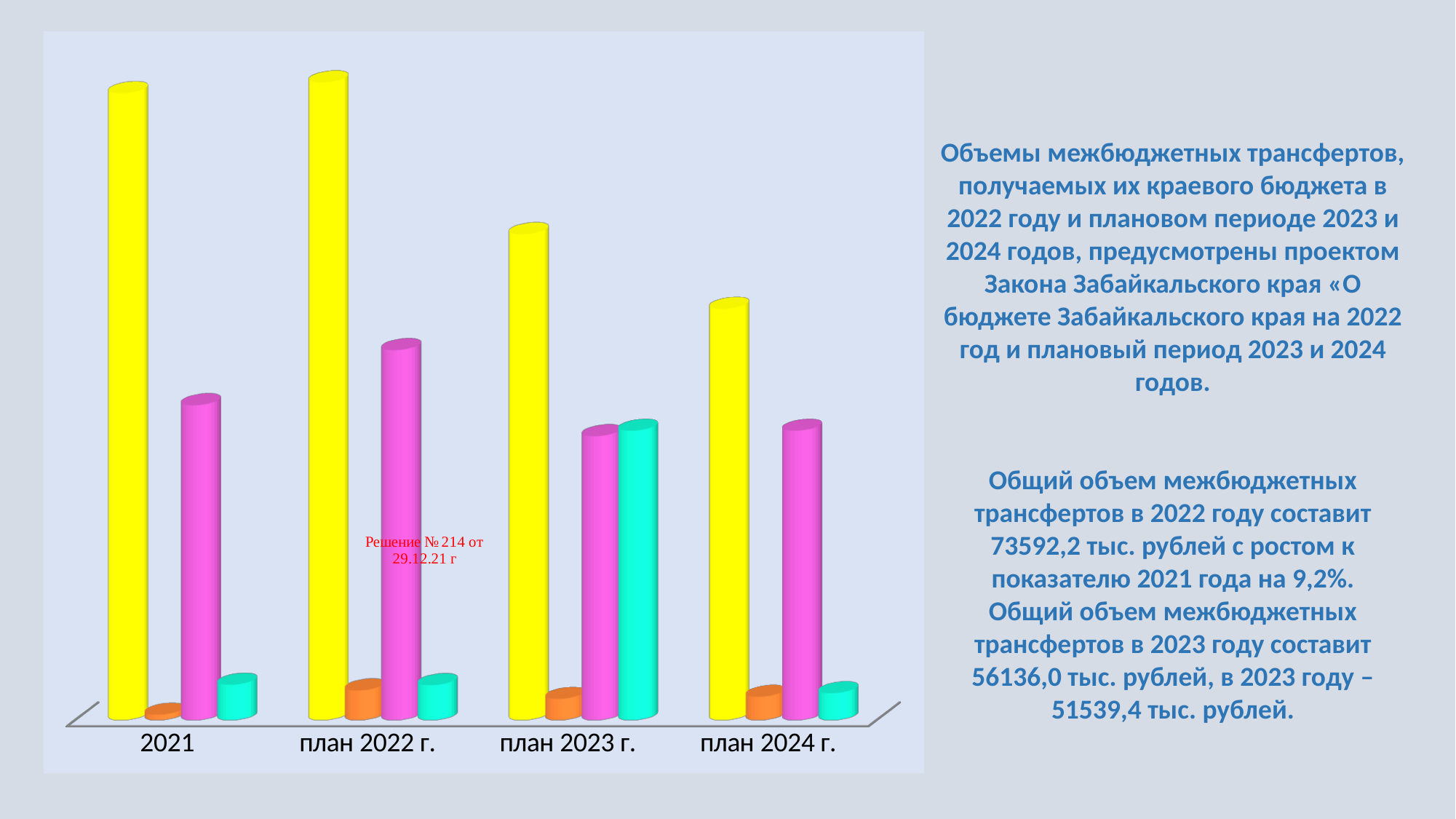
Which category has the tallest magenta bar? план 2022 г. What kind of chart is shown on the slide? bar chart What red text annotation is printed on the chart near the план 2022 г. bars? Решение № 214 от 29.12.21 г Which category has the tallest cyan bar? план 2023 г. Which category has the shortest yellow bar? план 2024 г. How many categories are shown on the x axis of the chart? 4 Is the cyan bar taller for план 2022 г. or for план 2023 г.? план 2023 г. Is the magenta bar taller for 2021 or for план 2023 г.? 2021 Which coloured bar is the shortest in the 2021 category? orange Do the yellow bars rise or fall from план 2022 г. to план 2024 г.? fall Is the yellow bar taller for план 2023 г. or for план 2024 г.? план 2023 г. How many differently coloured bars are shown for each category? 4